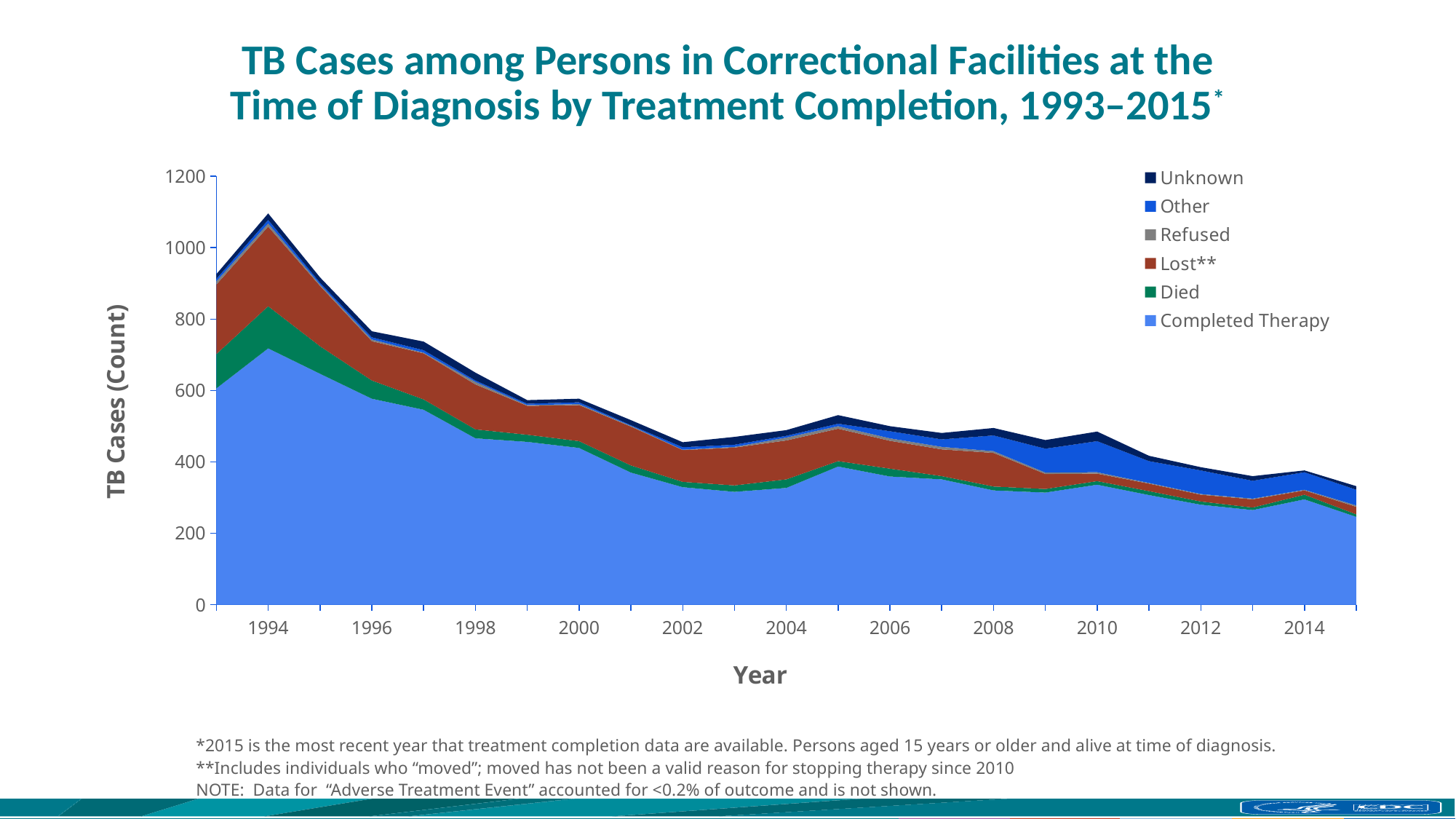
What is the label on the y axis? TB Cases (Count) Is the total number of TB cases in 1993 greater or less than 800? greater Is the total number of TB cases in 2015 greater or less than 400? less Is the total number of TB cases in 1994 greater or less than 1000? greater Overall, do total TB cases rise or fall from 1994 to 2015? fall Which year has a larger total number of TB cases, 1994 or 2015? 1994 Which year has the highest total number of TB cases? 1994 How many years are plotted along the x axis? 23 What kind of chart is shown on the slide? stacked area chart How many series does the legend list? 6